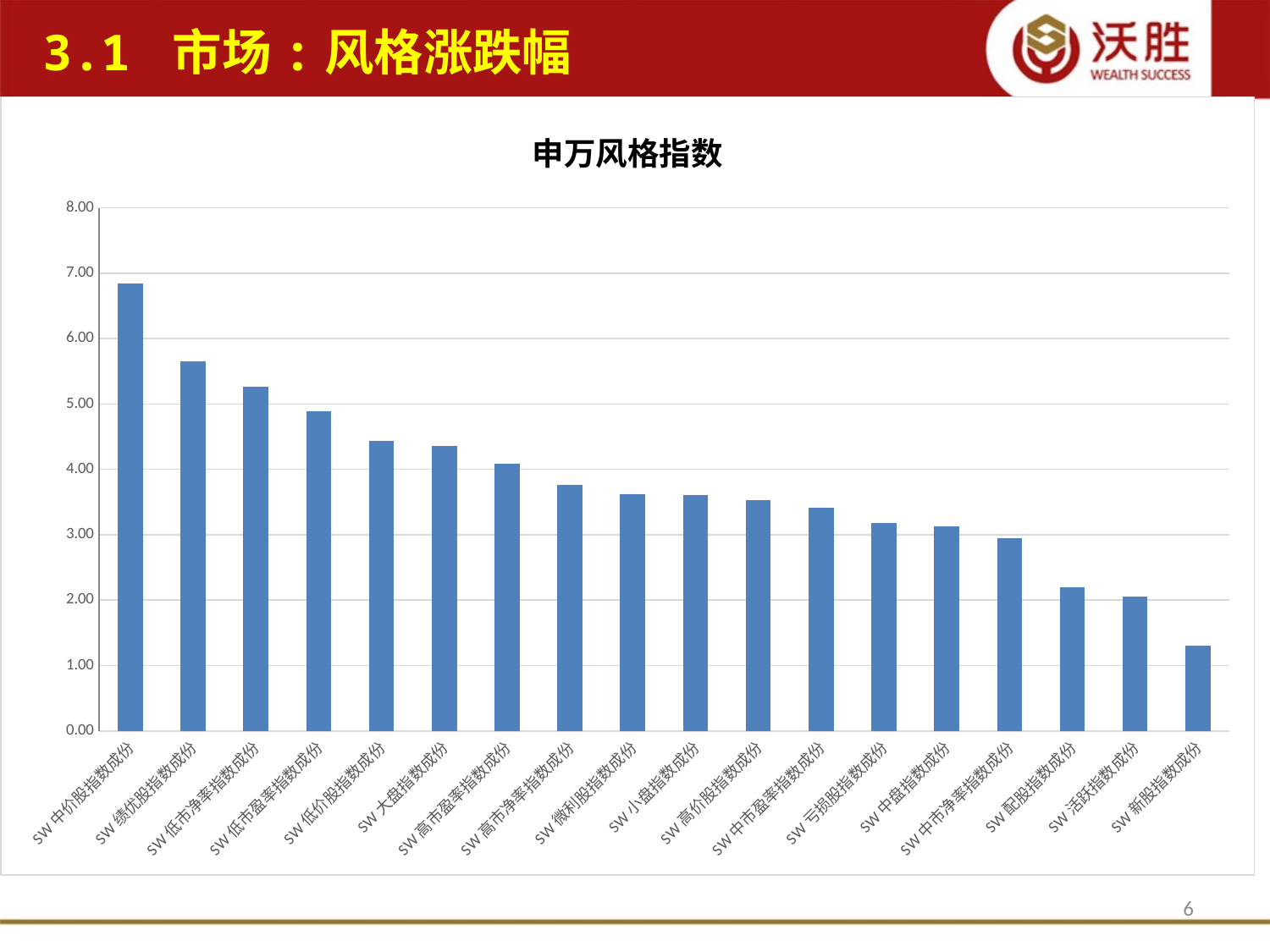
What kind of chart is shown on the slide? bar chart Do the bar values rise or fall from left to right along the x axis? fall Which category has the highest value in the chart? SW 中价股指数成份 Which is larger, the value for SW 低市净率指数成份 or the value for SW 大盘指数成份? SW 低市净率指数成份 How many categories (bars) are plotted in the chart? 18 Which category has the lowest value in the chart? SW 新股指数成份 Is the value for SW 绩优股指数成份 greater or less than 5.00? greater Which is larger, the value for SW 配股指数成份 or the value for SW 亏损股指数成份? SW 亏损股指数成份 What is the title of the chart? 申万风格指数 Is the value for SW 中价股指数成份 greater or less than 6.00? greater Is the value for SW 新股指数成份 greater or less than 2.00? less